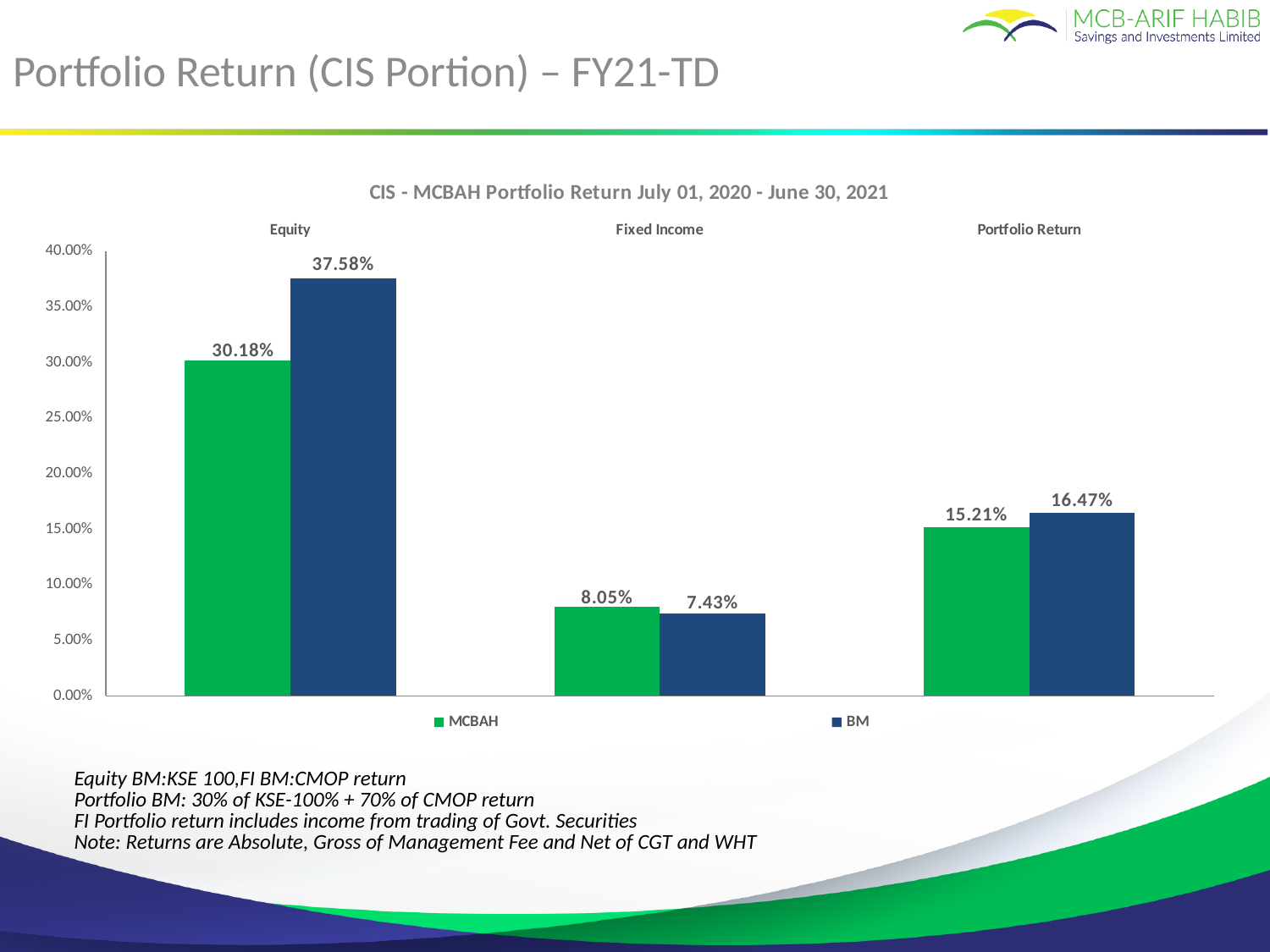
What is the title of the chart? CIS - MCBAH Portfolio Return July 01, 2020 - June 30, 2021 What kind of chart is shown on the slide? Bar chart How many categories are shown on the x axis? 3 Which category has the highest BM value? Equity What is the MCBAH return for Equity? 30.18% Which category has the lowest MCBAH value? Fixed Income What is the BM return for Equity? 37.58% What is the difference between the BM and MCBAH values for Equity? 7.40% What is the BM value for Portfolio Return? 16.47% What is the MCBAH return for Fixed Income? 8.05% How many series does the legend list? 2 For Fixed Income, which is larger, MCBAH or BM? MCBAH